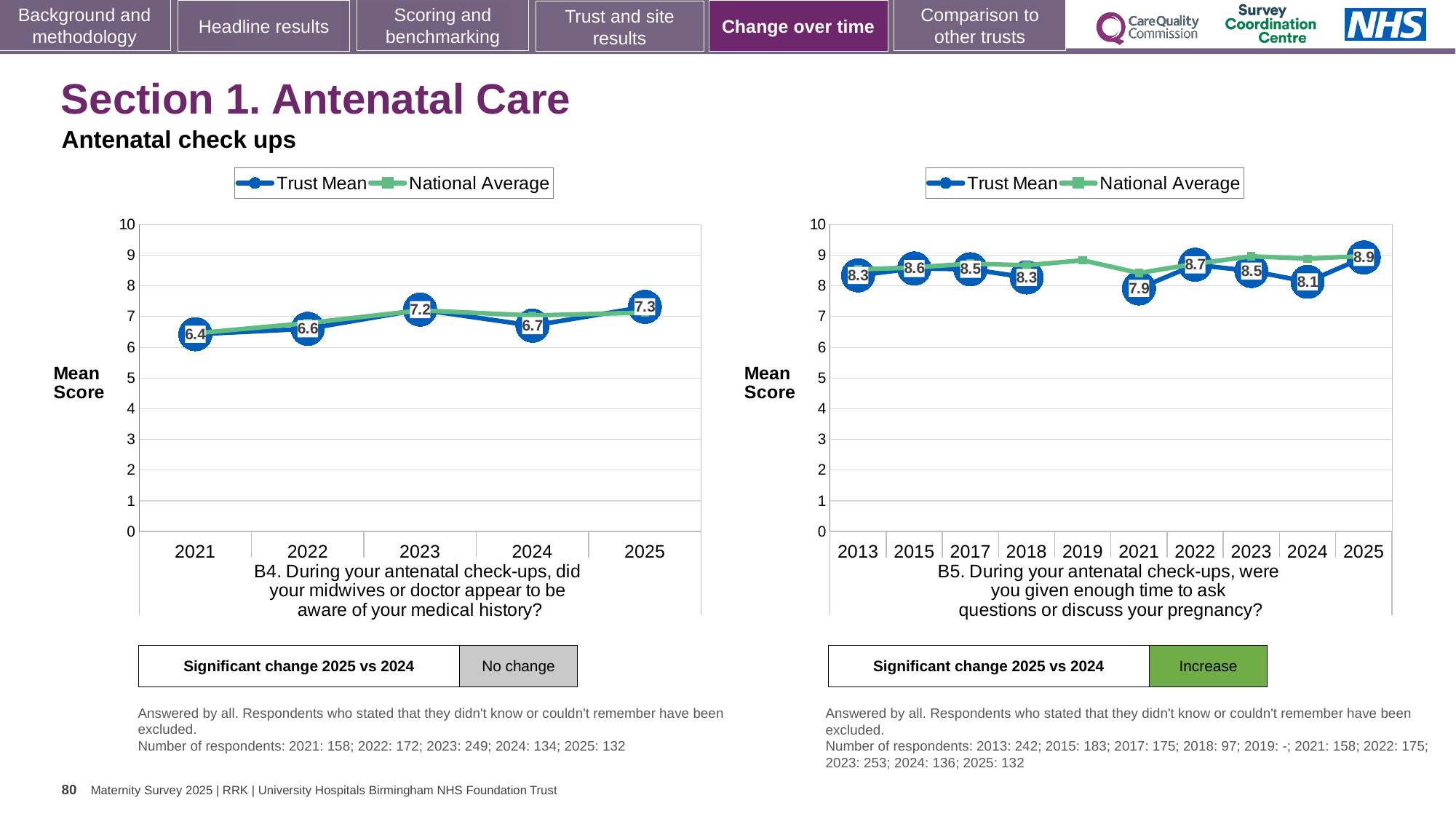
In the right chart (B5), is the Trust Mean for 2024 larger or smaller than the Trust Mean for 2022? smaller In the left chart (B4), how many years are shown on the x axis? 5 What type of chart is the left chart (B4)? line chart In the right chart (B5), which year has the lowest Trust Mean? 2021 In the right chart (B5), how many series does the legend list? 2 In the left chart (B4), what is the Trust Mean for 2021? 6.4 In the left chart (B4), what is the difference between the Trust Mean for 2025 and 2024? 0.6 In the right chart (B5), which year has the highest Trust Mean? 2025 In the right chart (B5), what is the Trust Mean for 2021? 7.9 In the left chart (B4), which year has the lowest Trust Mean? 2021 In the right chart (B5), what is the Trust Mean for 2025? 8.9 In the left chart (B4), what is the Trust Mean for 2025? 7.3